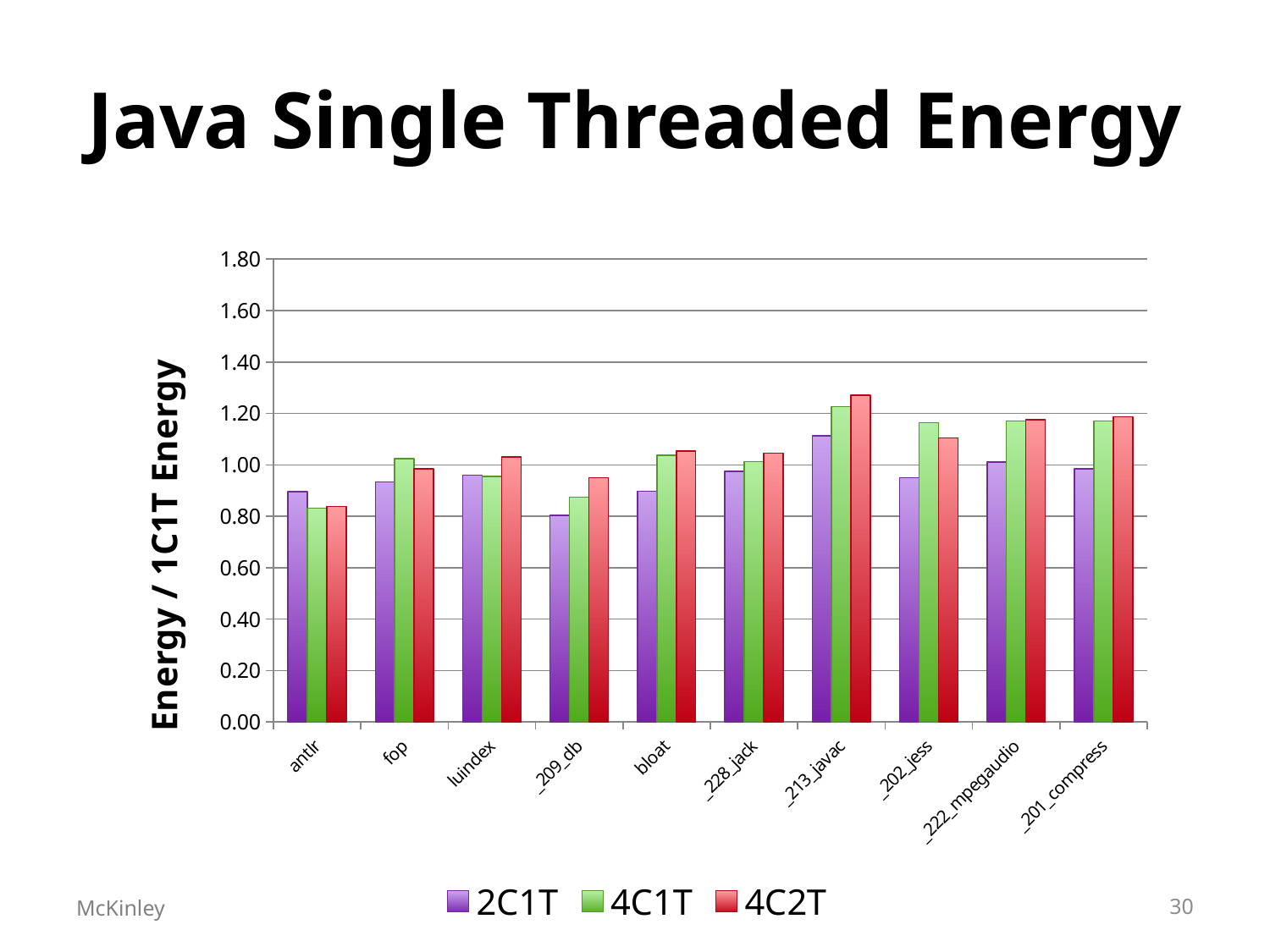
What is the label of the y axis? Energy / 1C1T Energy Is the 4C1T value for _202_jess greater or less than 1.00? greater Which benchmark has the lowest 4C2T value? antlr Which benchmark has the lowest 2C1T value? _209_db Is the 2C1T value for antlr greater or less than 1.00? less Which benchmark has the highest 4C2T value? _213_javac For _202_jess, which is larger: the 4C1T value or the 4C2T value? 4C1T How many benchmark categories are shown on the x axis? 10 How many series does the legend list? 3 Is the 4C2T value for _213_javac greater or less than 1.20? greater For antlr, which is larger: the 2C1T value or the 4C1T value? 2C1T What kind of chart is shown on the slide? bar chart